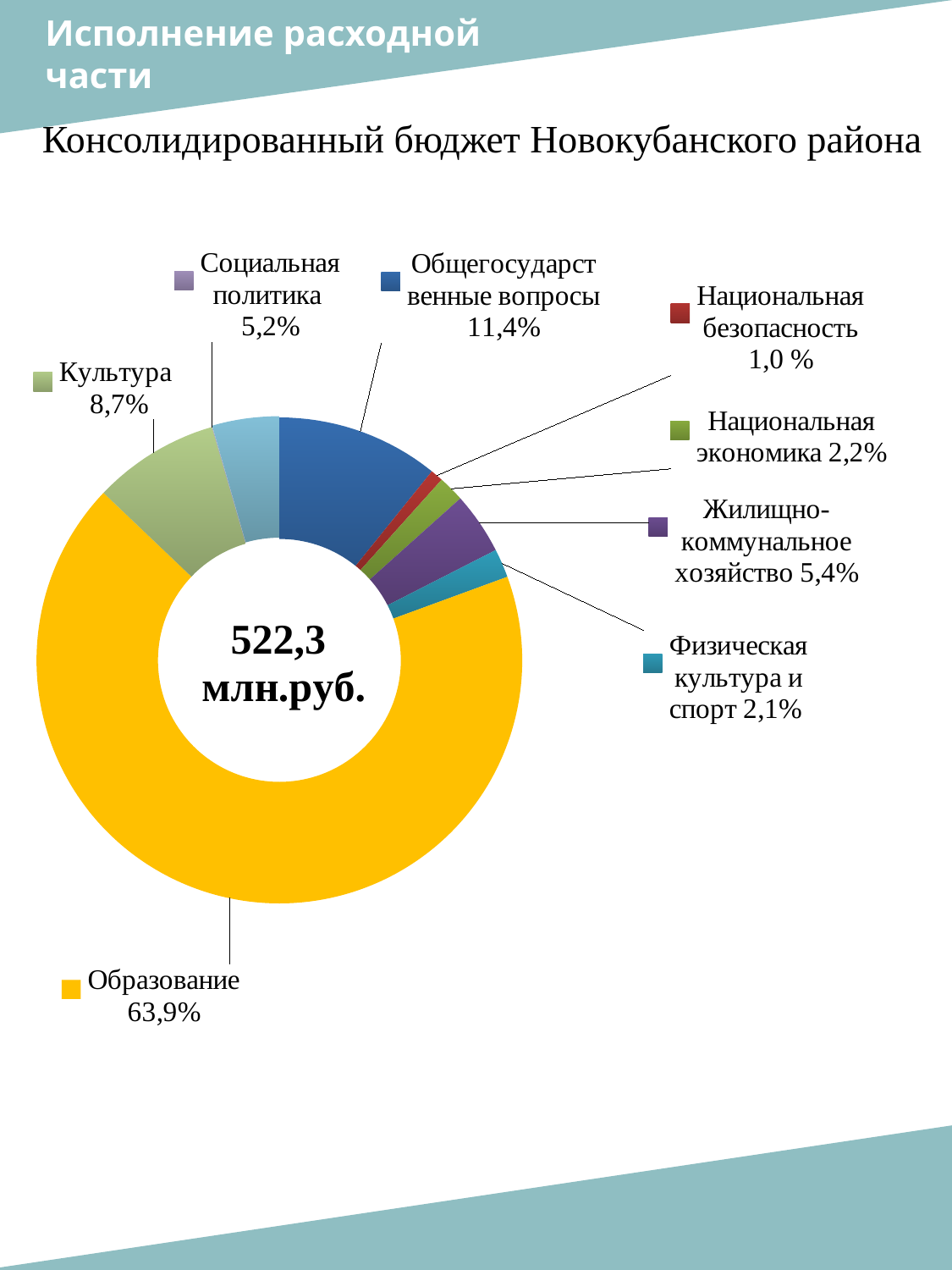
What share of the chart does Образование account for? 63,9% What is the value shown for Общегосударственные вопросы? 11,4% What kind of chart is shown on the slide? Doughnut (pie) chart What total amount is printed in the centre of the chart? 522,3 млн.руб. Which category has the largest share of the chart? Образование How many categories are shown in the chart? 8 What is the difference in percentage points between Общегосударственные вопросы and Культура? 2,7 Which is larger, the share for Национальная экономика or the share for Физическая культура и спорт? Национальная экономика What percentage is shown for Жилищно-коммунальное хозяйство? 5,4% Which category has the smallest share of the chart? Национальная безопасность What is the value for Культура? 8,7% Which is larger, the share for Социальная политика or the share for Жилищно-коммунальное хозяйство? Жилищно-коммунальное хозяйство